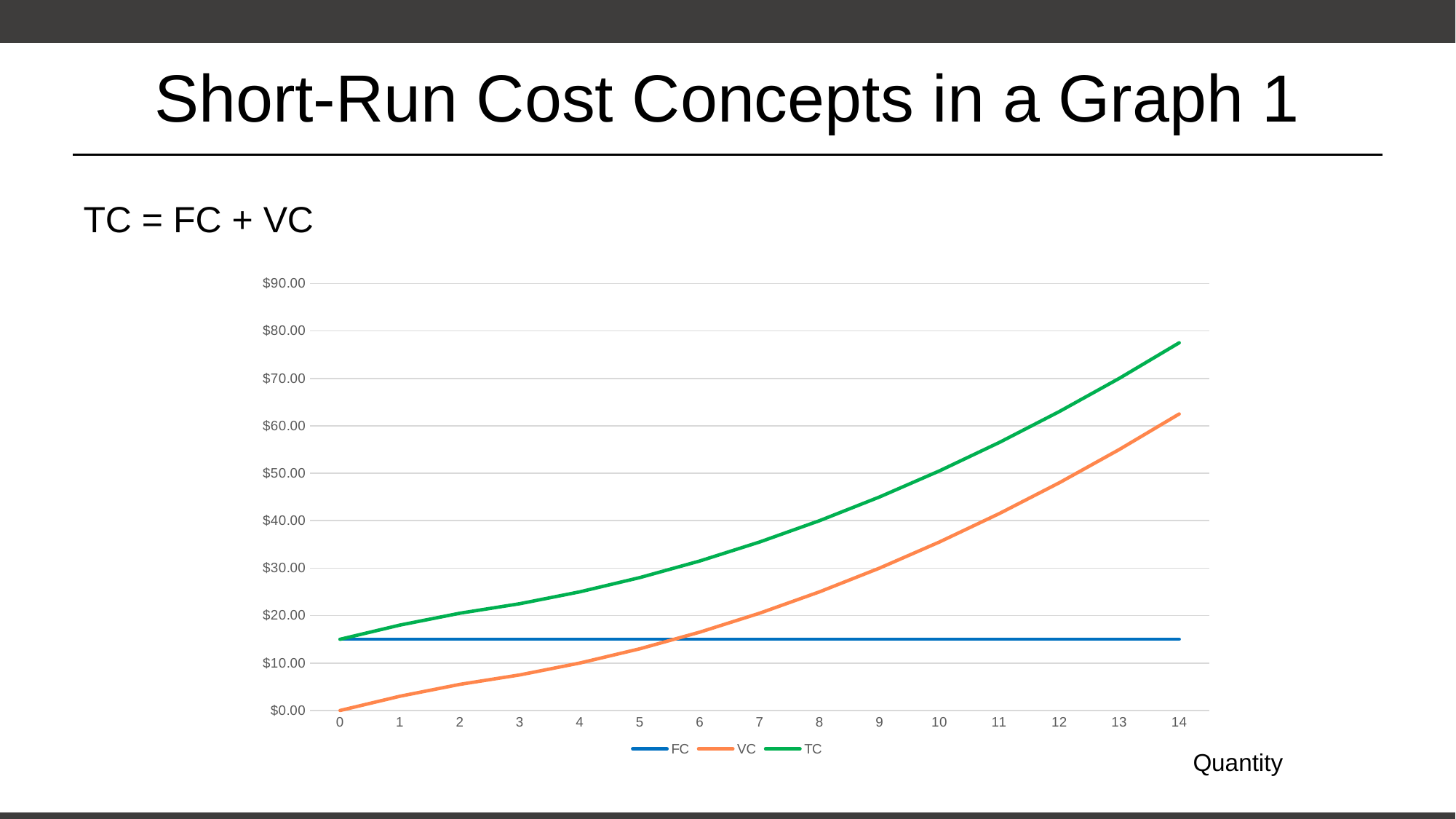
Is the value of TC at quantity 14 greater or less than $70.00? greater How many series does the chart's legend list? 3 Does the VC line rise or fall as quantity increases? rises Does the FC line rise, fall, or stay flat as quantity increases? stays flat What is the value of VC at quantity 0? $0.00 Is the value of VC at quantity 14 greater or less than $70.00? less Is the value of FC at quantity 10 greater or less than $20.00? less Which series has the lowest value at quantity 14? FC Which series has the highest value at quantity 14? TC What kind of chart is shown on the slide? line chart What label is shown for the x axis of the chart? Quantity How many quantity values are plotted along the x axis? 15